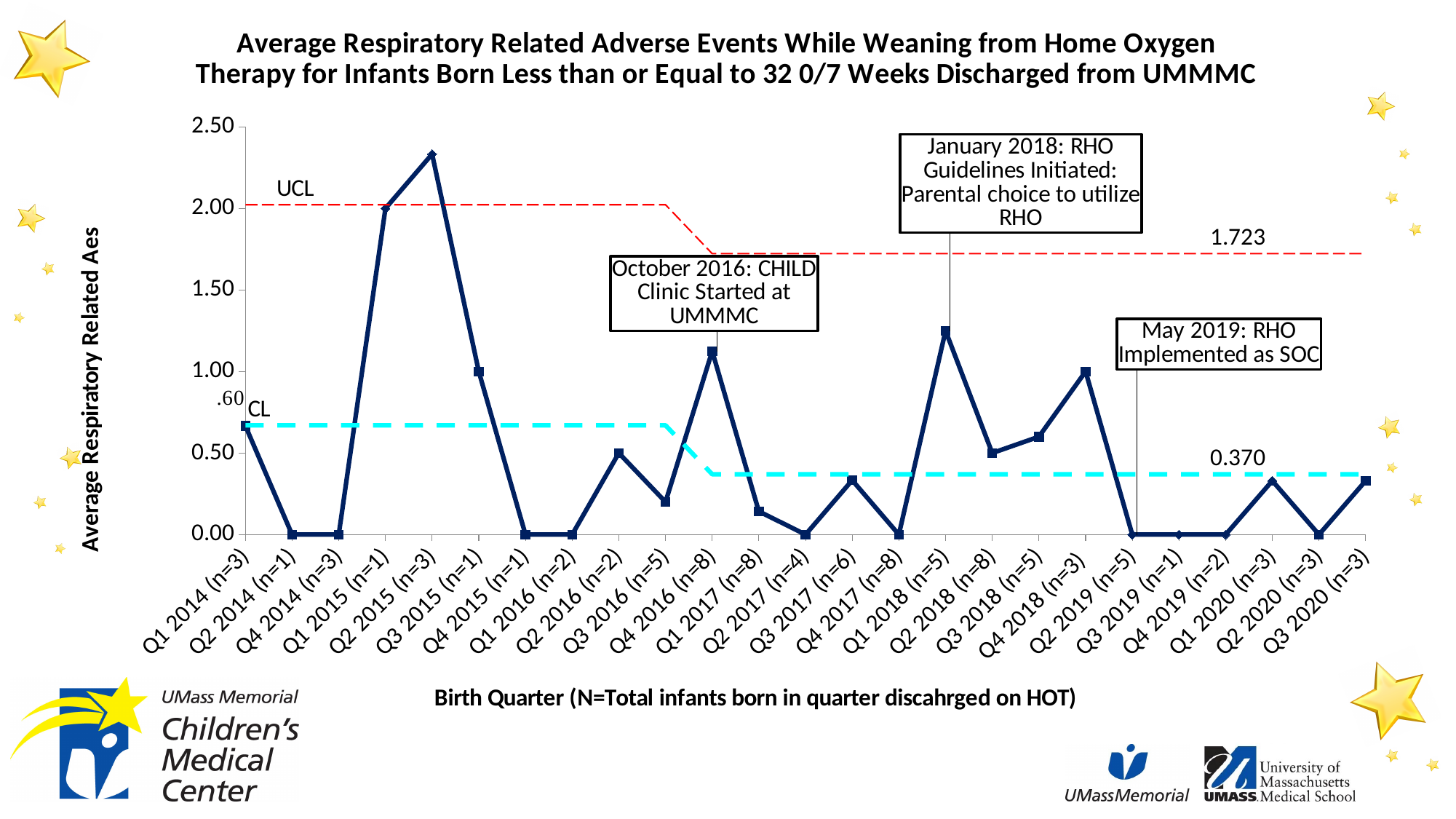
How many birth quarters are plotted along the x axis? 25 What is the average respiratory related adverse events value for Q3 2015 (n=1)? 1.00 Which is larger, the value for Q1 2018 (n=5) or the value for Q4 2018 (n=3)? Q1 2018 (n=5) What value is labelled on the UCL line in the later part of the chart? 1.723 What is the average respiratory related adverse events value for Q4 2018 (n=3)? 1.00 What value is labelled on the CL line in the later part of the chart? 0.370 Which birth quarter has the highest average respiratory related adverse events? Q2 2015 (n=3) What is the average respiratory related adverse events value for Q2 2016 (n=2)? 0.50 Is the value for Q2 2015 (n=3) greater or less than 2.00? greater What is the difference between the values for Q3 2015 (n=1) and Q2 2016 (n=2)? 0.50 Is the value for Q3 2018 (n=5) greater or less than 1.00? less What kind of chart is shown on the slide? line chart